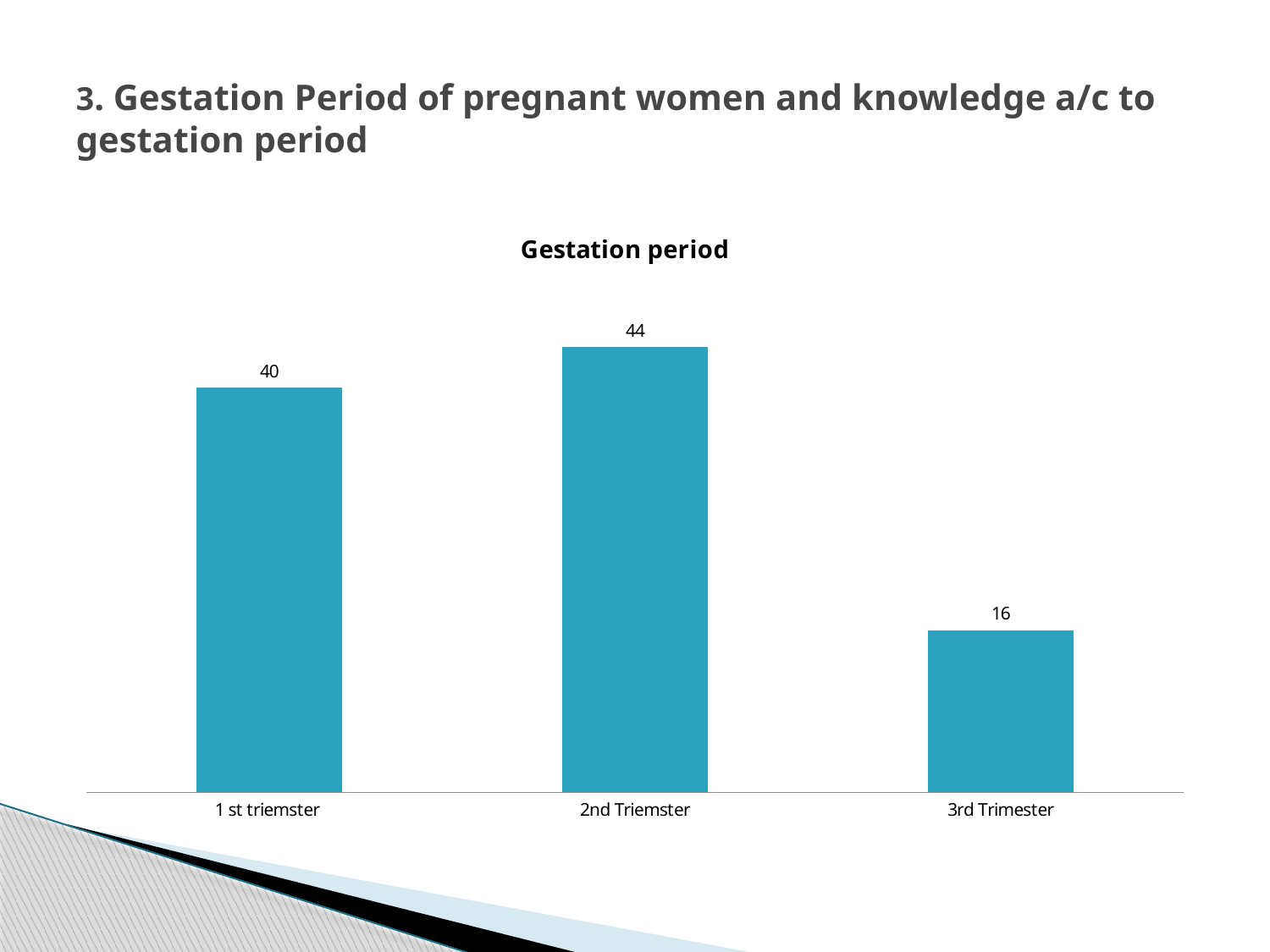
What is the value for 1 st triemster? 40 How many categories are shown on the x axis? 3 What is the difference between the values for 2nd Triemster and 3rd Trimester? 28 What is the title of the chart? Gestation period Which is larger, the value for 1 st triemster or the value for 3rd Trimester? 1 st triemster What is the difference between the values for 2nd Triemster and 1 st triemster? 4 What kind of chart is shown on the slide? bar chart What is the total of the three values shown in the chart? 100 Which category has the highest value? 2nd Triemster What is the value for 3rd Trimester? 16 Which category has the lowest value? 3rd Trimester What is the value for 2nd Triemster? 44